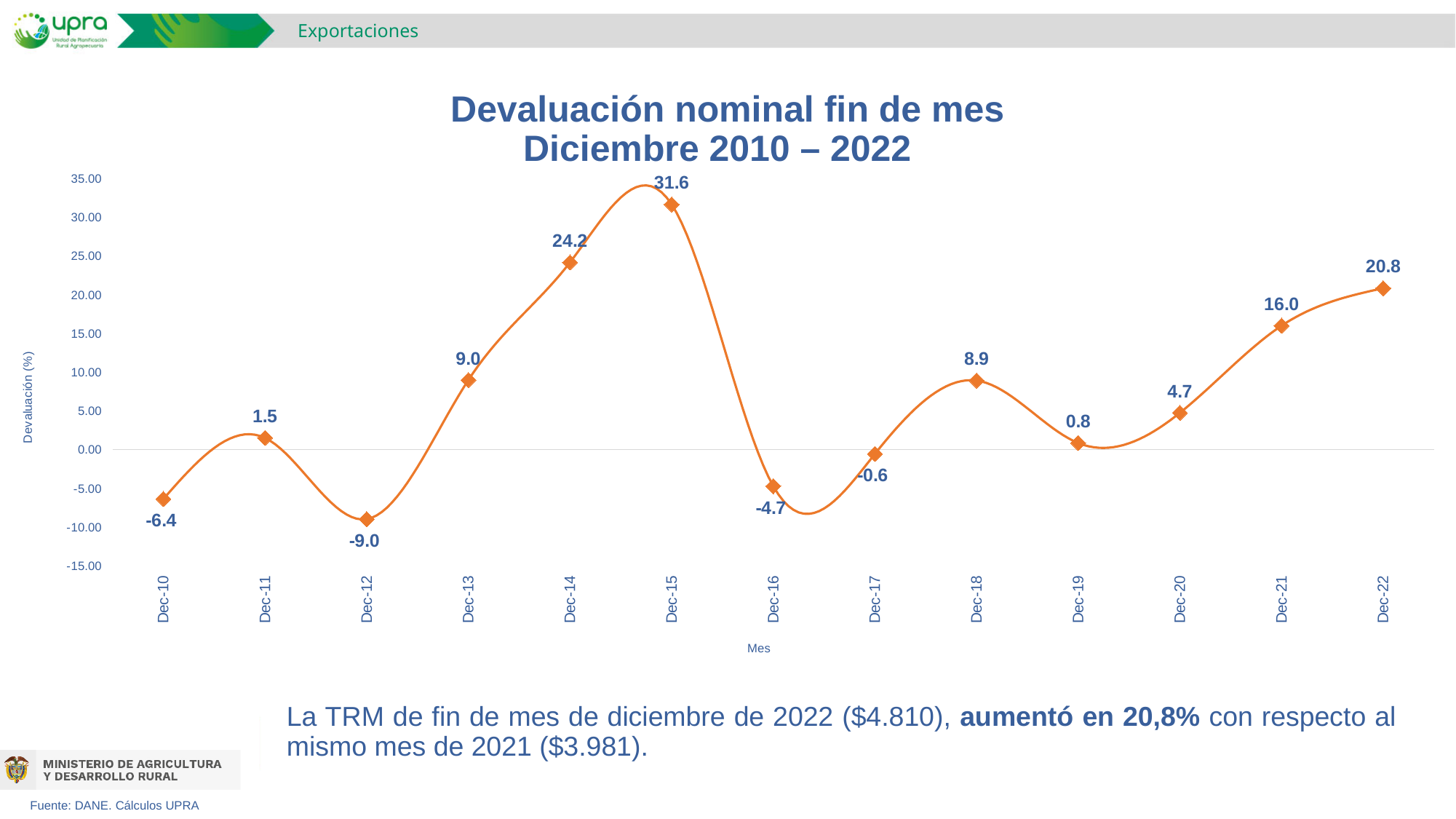
Which month has the lowest value? Dec-12 What is the value for Dec-22? 20.8 Which month has the highest value? Dec-15 What is the label of the y axis? Devaluación (%) What is the value for Dec-12? -9.0 What is the title of the chart? Devaluación nominal fin de mes Diciembre 2010 – 2022 Do the values rise or fall from Dec-19 to Dec-22? Rise How many data points are plotted on the chart? 13 What is the difference between the values for Dec-22 and Dec-21? 4.8 What is the value for Dec-15? 31.6 Which is larger, the value for Dec-14 or the value for Dec-18? Dec-14 What kind of chart is shown? Line chart